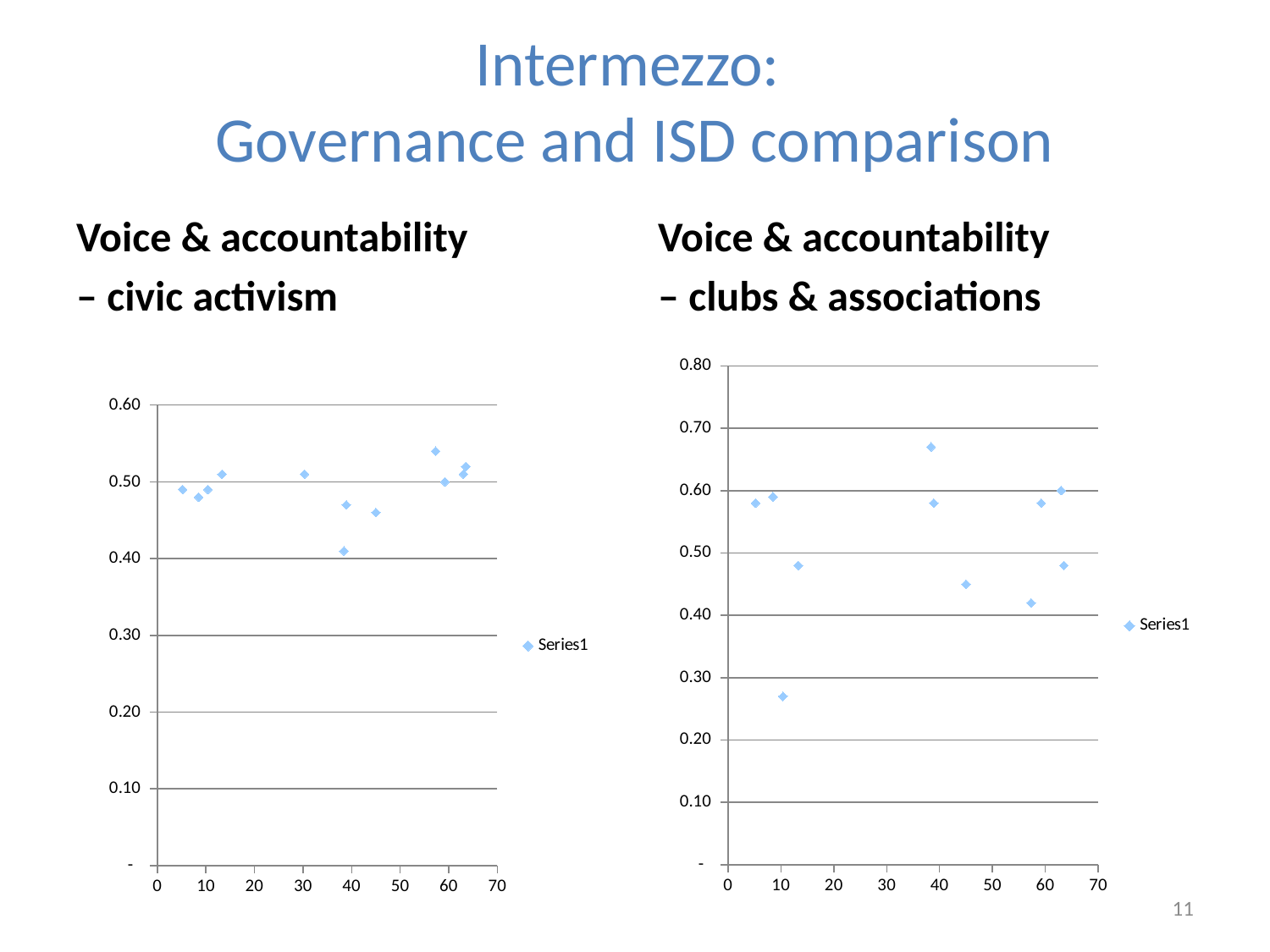
What is the highest value shown on the y axis of the right chart, 'Voice & accountability – clubs & associations'? 0.80 In the right chart, 'Voice & accountability – clubs & associations', how many series does the legend list? 1 What is the name of the series shown in the legend of the left chart, 'Voice & accountability – civic activism'? Series1 What kind of chart is the left chart, 'Voice & accountability – civic activism'? scatter chart In the left chart, 'Voice & accountability – civic activism', is the lowest plotted value greater or less than 0.50? less In the left chart, 'Voice & accountability – civic activism', is the highest plotted value greater or less than 0.50? greater In the left chart, 'Voice & accountability – civic activism', are all plotted values greater or less than 0.60? less In the left chart, 'Voice & accountability – civic activism', how many series does the legend list? 1 What kind of chart is the right chart, 'Voice & accountability – clubs & associations'? scatter chart